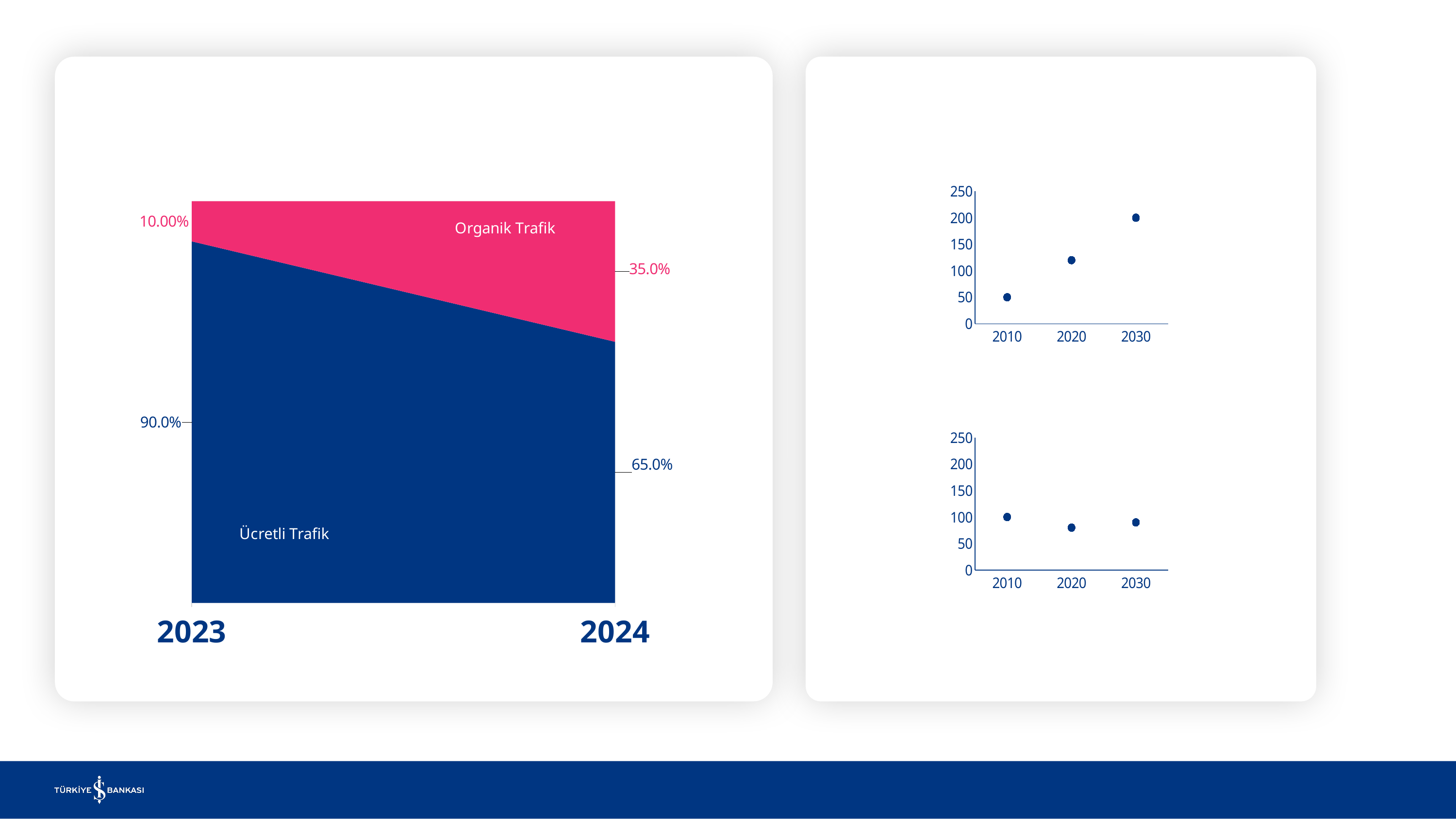
On the top right chart, is the value for 2020 greater or less than 100? greater On the left chart, what is the value for Organik Trafik in 2024? 35.0% On the bottom right chart, how many data points are plotted? 3 On the left chart, which series is larger in 2024, Organik Trafik or Ücretli Trafik? Ücretli Trafik On the top right chart, do the values rise or fall from 2010 to 2030? rise On the top right chart, what is the value for 2010? 50 On the left chart, what is the value for Organik Trafik in 2023? 10.00% On the left chart, does the share of Organik Trafik rise or fall from 2023 to 2024? rise On the bottom right chart, which year has the highest value? 2010 On the left chart, by how many percentage points does Ücretli Trafik fall from 2023 to 2024? 25.0 percentage points On the left chart, how many series are shown? 2 On the left chart, what is the value for Ücretli Trafik in 2024? 65.0%